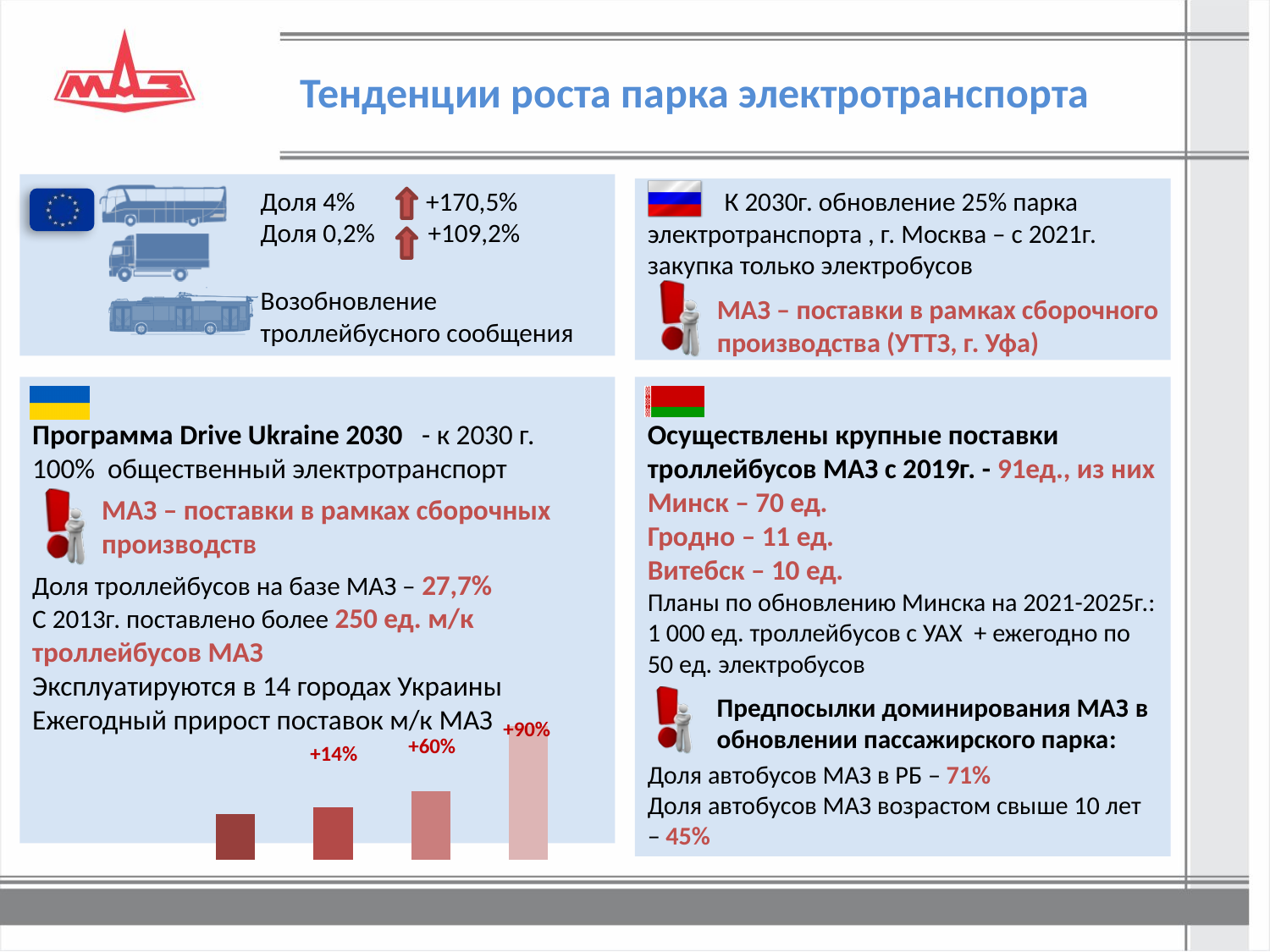
In the bar chart at the bottom left, what value is labelled on the tallest (rightmost) bar? +90% What colour family are the bars in the chart at the bottom left of the slide? shades of red, getting lighter from left to right In the bar chart at the bottom left, which bar is the lowest? the first (leftmost) bar In the bar chart at the bottom left, what value is labelled on the second bar from the left? +14% How many bars does the chart at the bottom left of the slide contain? 4 In the bar chart at the bottom left, what is the difference in percentage points between the +90% bar and the +60% bar? 30 percentage points In the bar chart at the bottom left, how many bars carry a printed percentage label? 3 In the bar chart at the bottom left, what is the difference in percentage points between the +60% bar and the +14% bar? 46 percentage points In the bar chart at the bottom left, what value is labelled on the third bar from the left? +60% In the bar chart at the bottom left, do the bar values rise or fall from left to right? rise What kind of chart is shown at the bottom left of the slide under "Ежегодный прирост поставок м/к МАЗ"? bar chart In the bar chart at the bottom left, which is larger: the third bar (+60%) or the second bar (+14%)? the third bar (+60%)